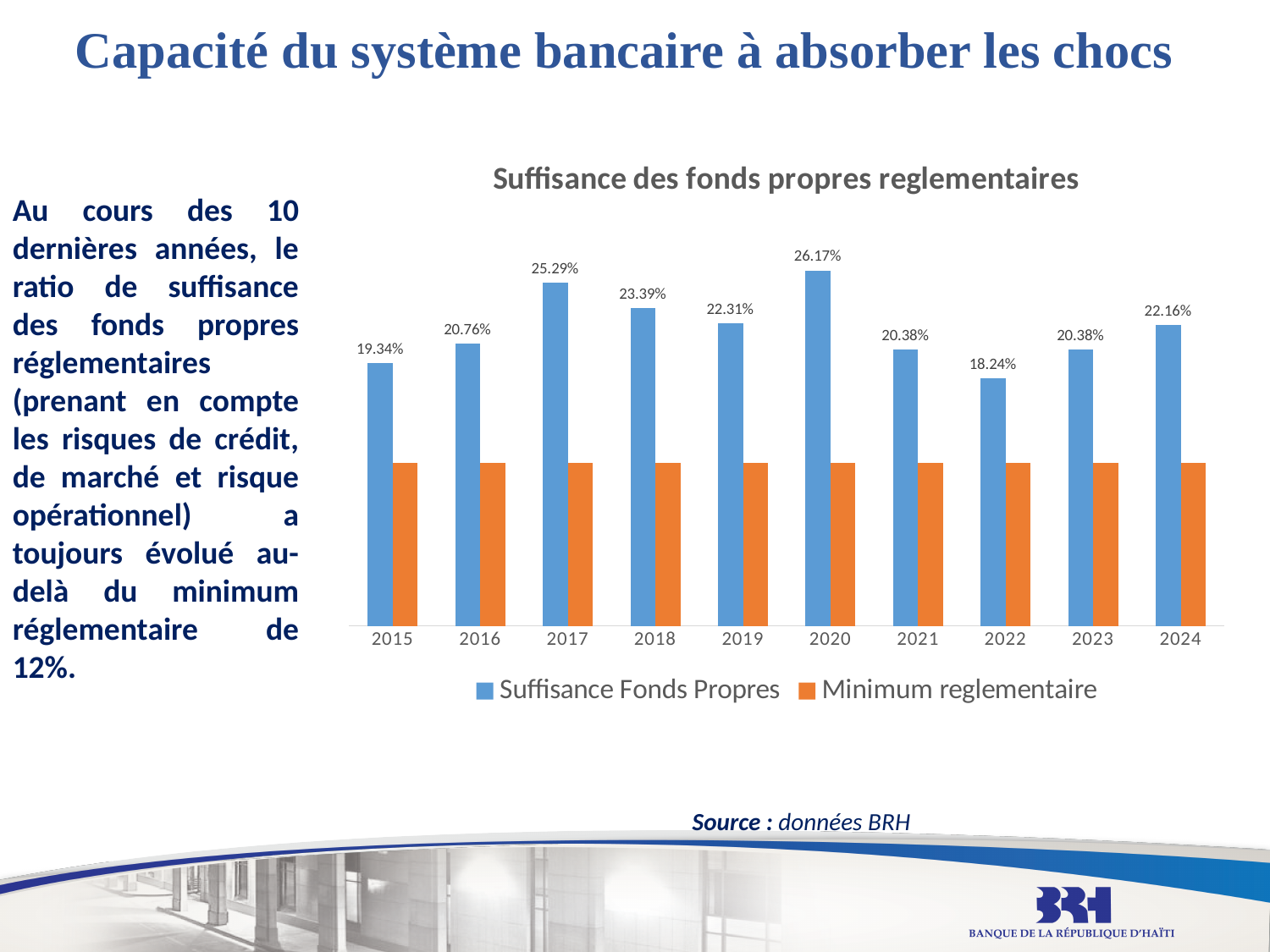
Which is larger, the Suffisance Fonds Propres value for 2018 or for 2019? 2018 What is the Suffisance Fonds Propres value for 2015? 19.34% What is the title of the chart? Suffisance des fonds propres reglementaires How many years are shown on the x axis of the chart? 10 What kind of chart is shown on the slide? Bar chart Which year has the highest Suffisance Fonds Propres value? 2020 What is the Suffisance Fonds Propres value for 2024? 22.16% Which year has the lowest Suffisance Fonds Propres value? 2022 What is the Suffisance Fonds Propres value for 2020? 26.17% What is the difference between the Suffisance Fonds Propres values for 2020 and 2022? 7.93 percentage points How many series does the chart legend list? 2 What is the difference between the Suffisance Fonds Propres values for 2017 and 2016? 4.53 percentage points